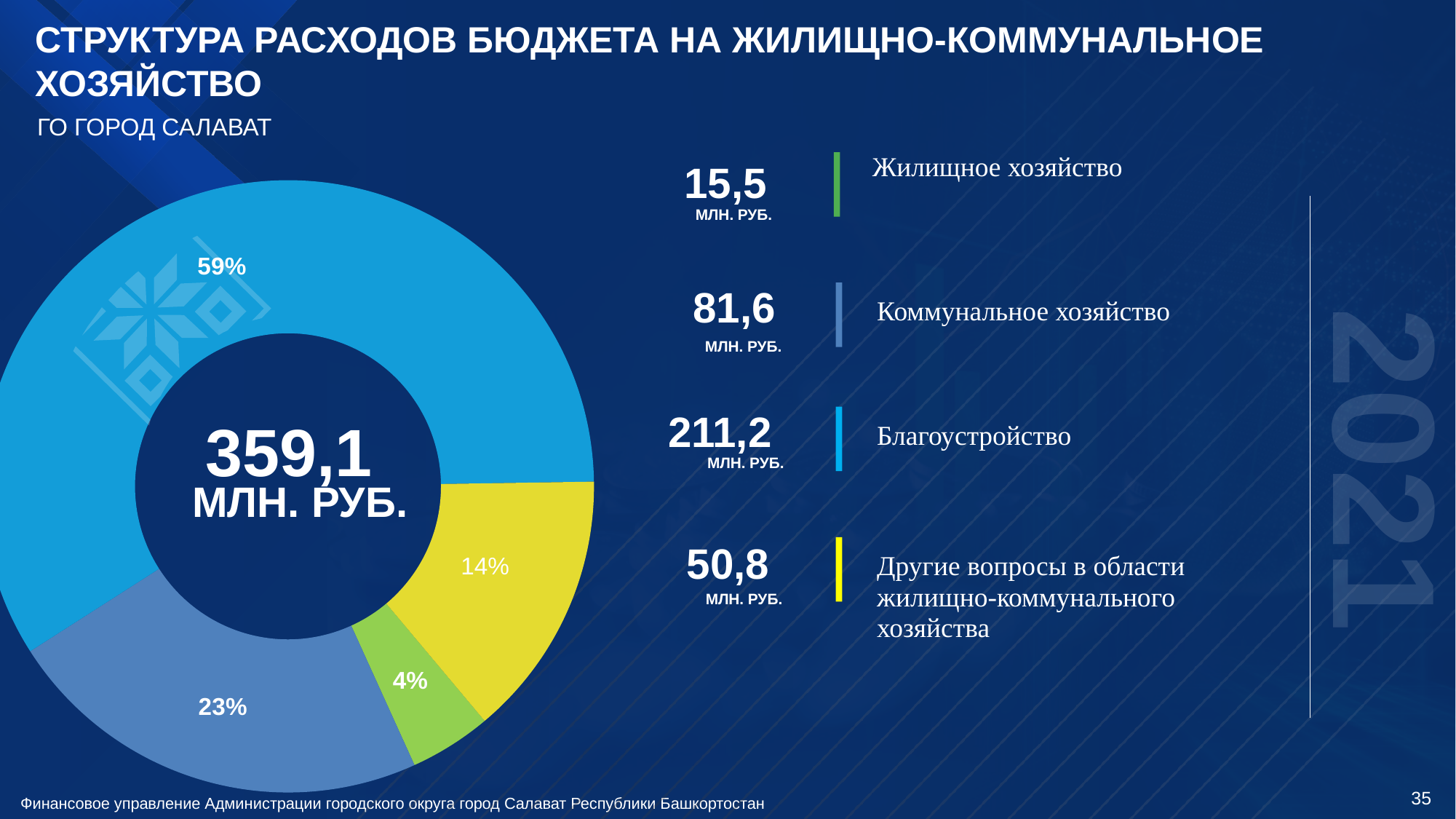
Which is larger: the value for Коммунальное хозяйство or the value for Другие вопросы в области жилищно-коммунального хозяйства? Коммунальное хозяйство What share of the chart does the light blue slice (Благоустройство) represent? 59% What share of the chart does the green slice (Жилищное хозяйство) represent? 4% What type of chart is shown on the slide? Pie (donut) chart What is the value for Коммунальное хозяйство in млн. руб.? 81,6 What is the difference in percentage points between the 59% slice and the 23% slice? 36% Which category has the smallest share of the chart? Жилищное хозяйство What is the value for Благоустройство in млн. руб.? 211,2 Which category has the largest share of the chart? Благоустройство What share of the chart does the yellow slice (Другие вопросы в области жилищно-коммунального хозяйства) represent? 14% What is the total value shown in the centre of the donut chart? 359,1 млн. руб. How many slices does the donut chart have? 4